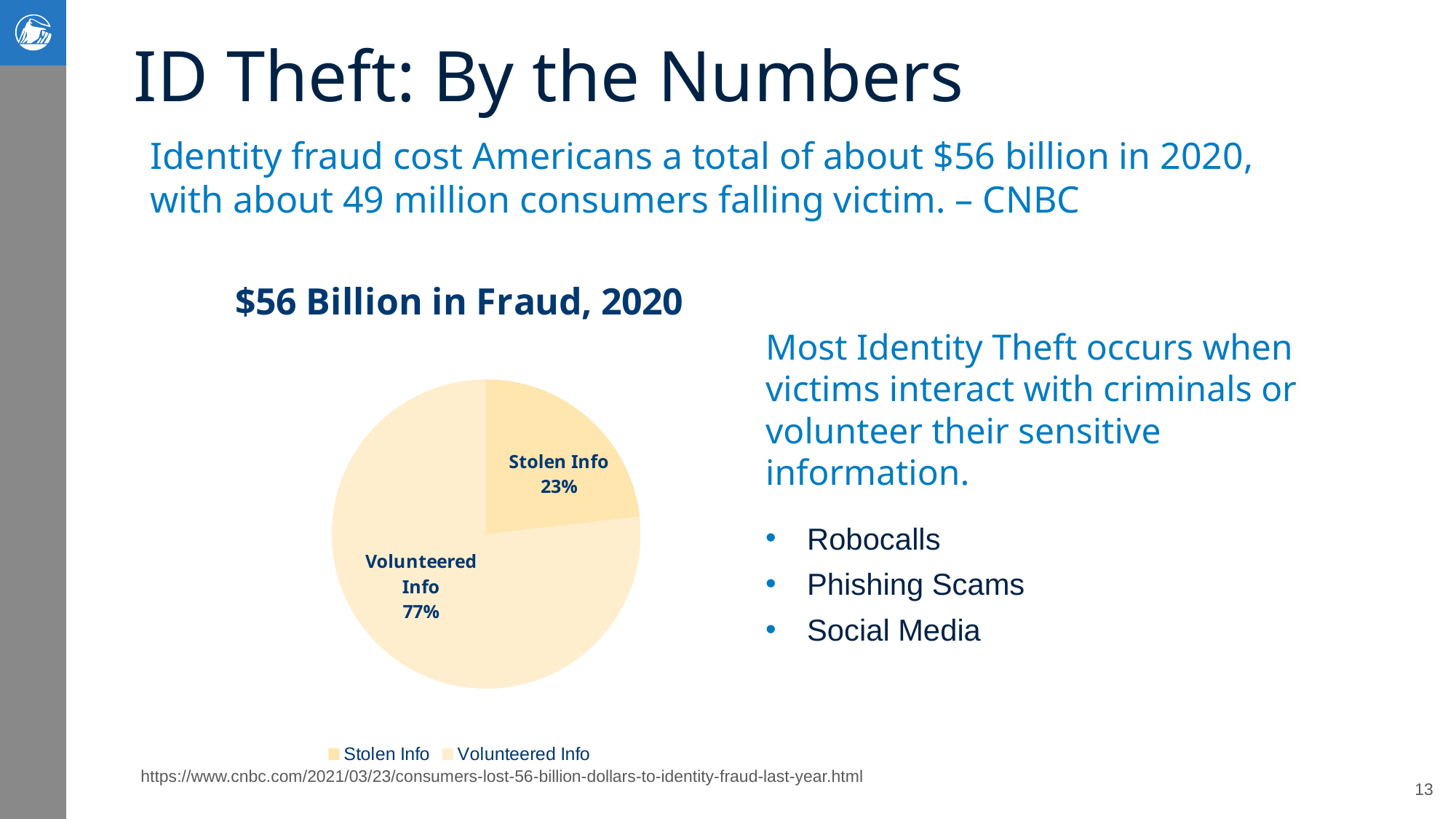
Which slice of the pie is the smallest? Stolen Info How many slices does the pie chart have? 2 How many entries does the legend list? 2 What kind of chart is shown on the slide? Pie chart What is the difference in percentage points between Volunteered Info and Stolen Info? 54 What share of the pie is Volunteered Info? 77% Which slice of the pie is the largest? Volunteered Info What share of the pie is Stolen Info? 23% What are the two legend entries of the chart? Stolen Info and Volunteered Info Which is larger, Stolen Info or Volunteered Info? Volunteered Info What is the title of the chart? $56 Billion in Fraud, 2020